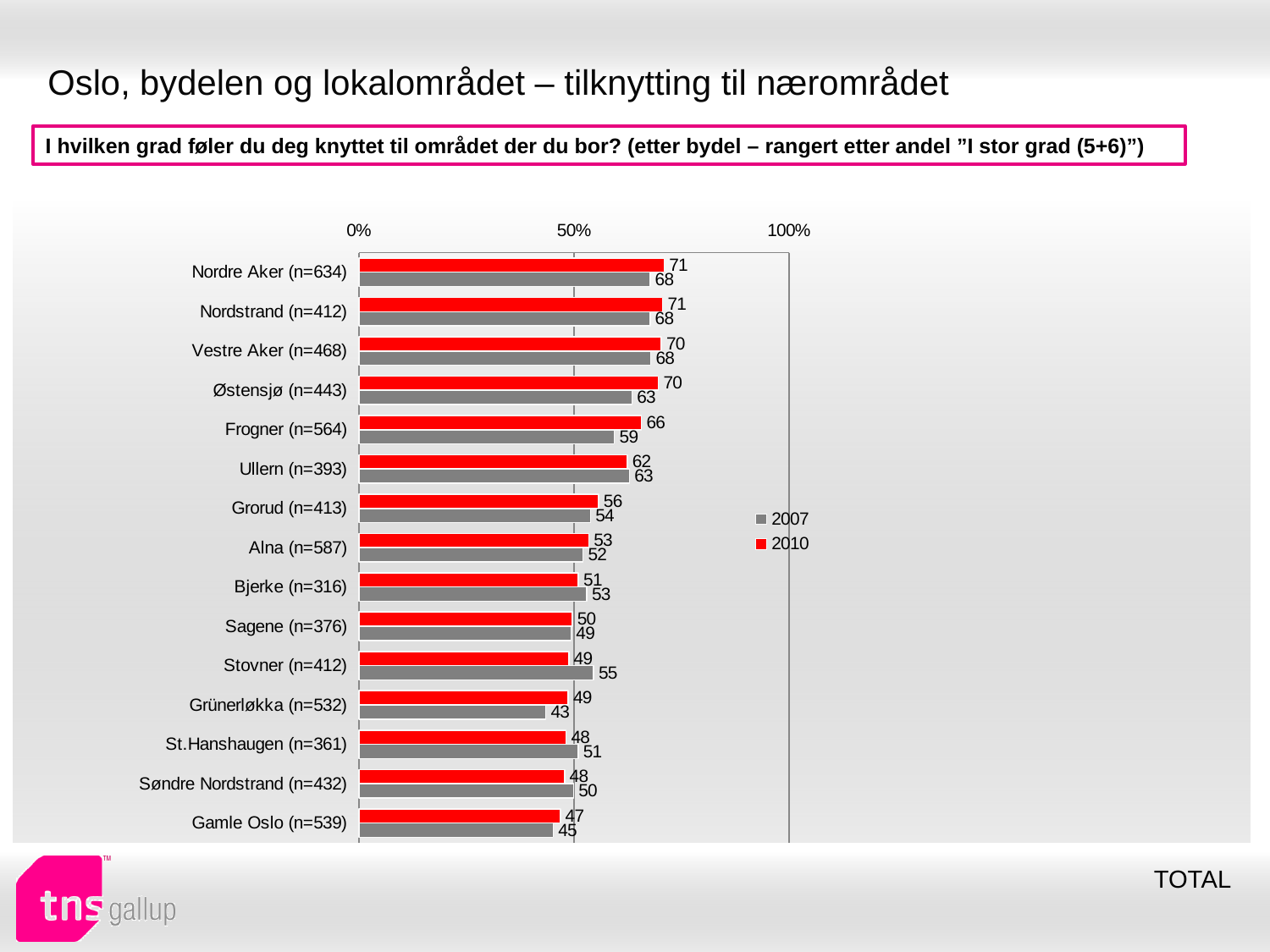
Which bydel has the lowest 2010 value? Gamle Oslo (n=539) What is the 2007 value for Østensjø (n=443)? 63 What kind of chart is shown on the slide? Bar chart What is the 2007 value for Stovner (n=412)? 55 What is the 2010 value for Frogner (n=564)? 66 Which bydel has the lowest 2007 value? Grünerløkka (n=532) What is the difference between the 2010 and 2007 values for Frogner (n=564)? 7 What is the difference between the 2007 and 2010 values for Stovner (n=412)? 6 For Ullern (n=393), which is larger: the 2007 value or the 2010 value? 2007 How many series does the legend list? 2 Is the 2010 value for Nordre Aker (n=634) greater or less than 50%? greater How many bydeler (categories) are shown in the chart? 15